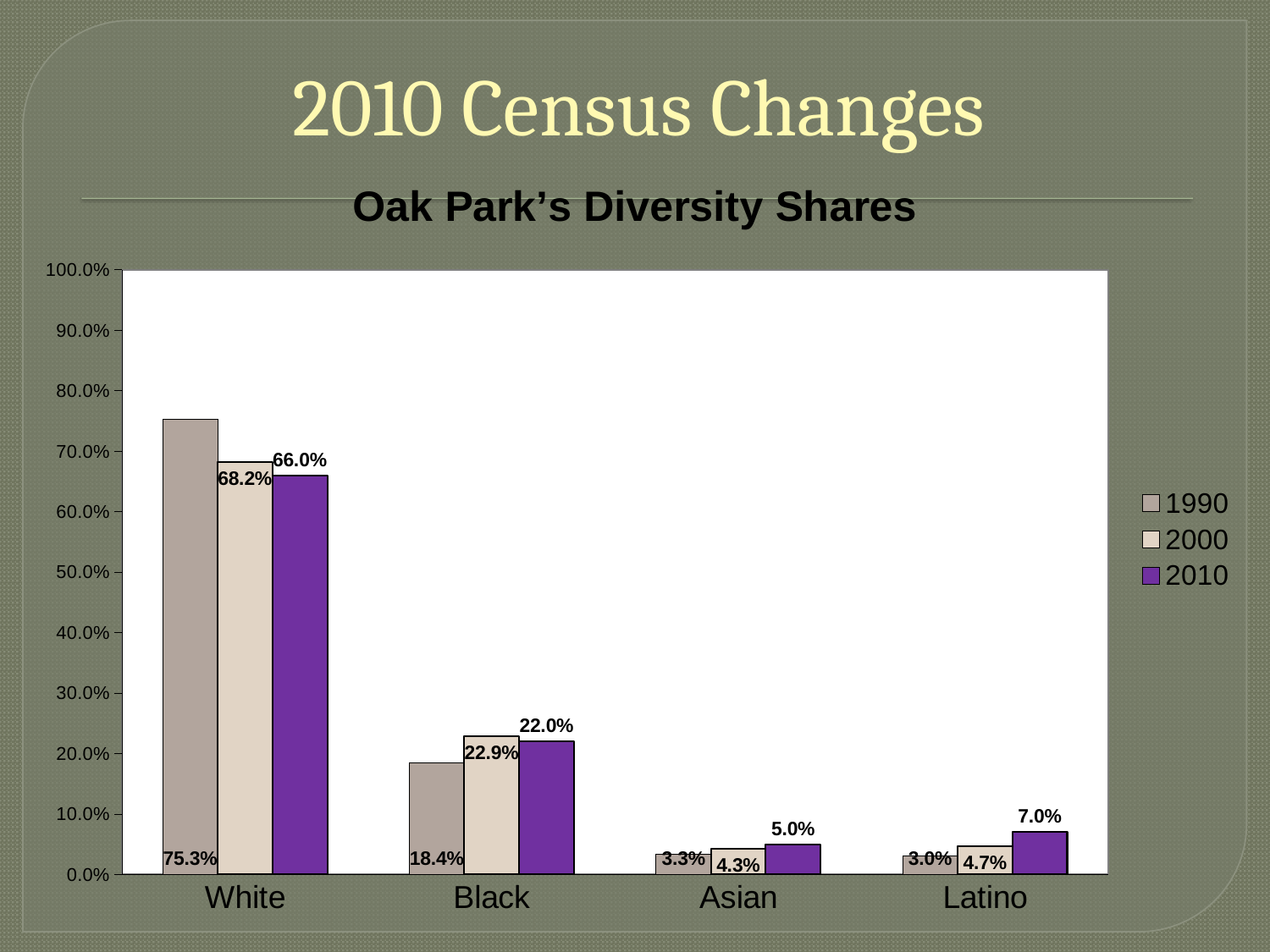
How many categories are shown on the x axis? 4 What kind of chart is shown? Bar chart By how many percentage points did the White share fall from 1990 to 2010? 9.3 What was the Asian share in 2000? 4.3% Which category had the highest share in 2010? White What was the Latino share in 2010? 7.0% What was the Black share in 2010? 22.0% Which is larger: the Black share in 2000 or the Black share in 2010? Black share in 2000 What was the White share in 1990? 75.3% Which category had the lowest share in 1990? Latino Is the White share in 1990 greater or less than 70.0%? greater How many series does the legend list? 3